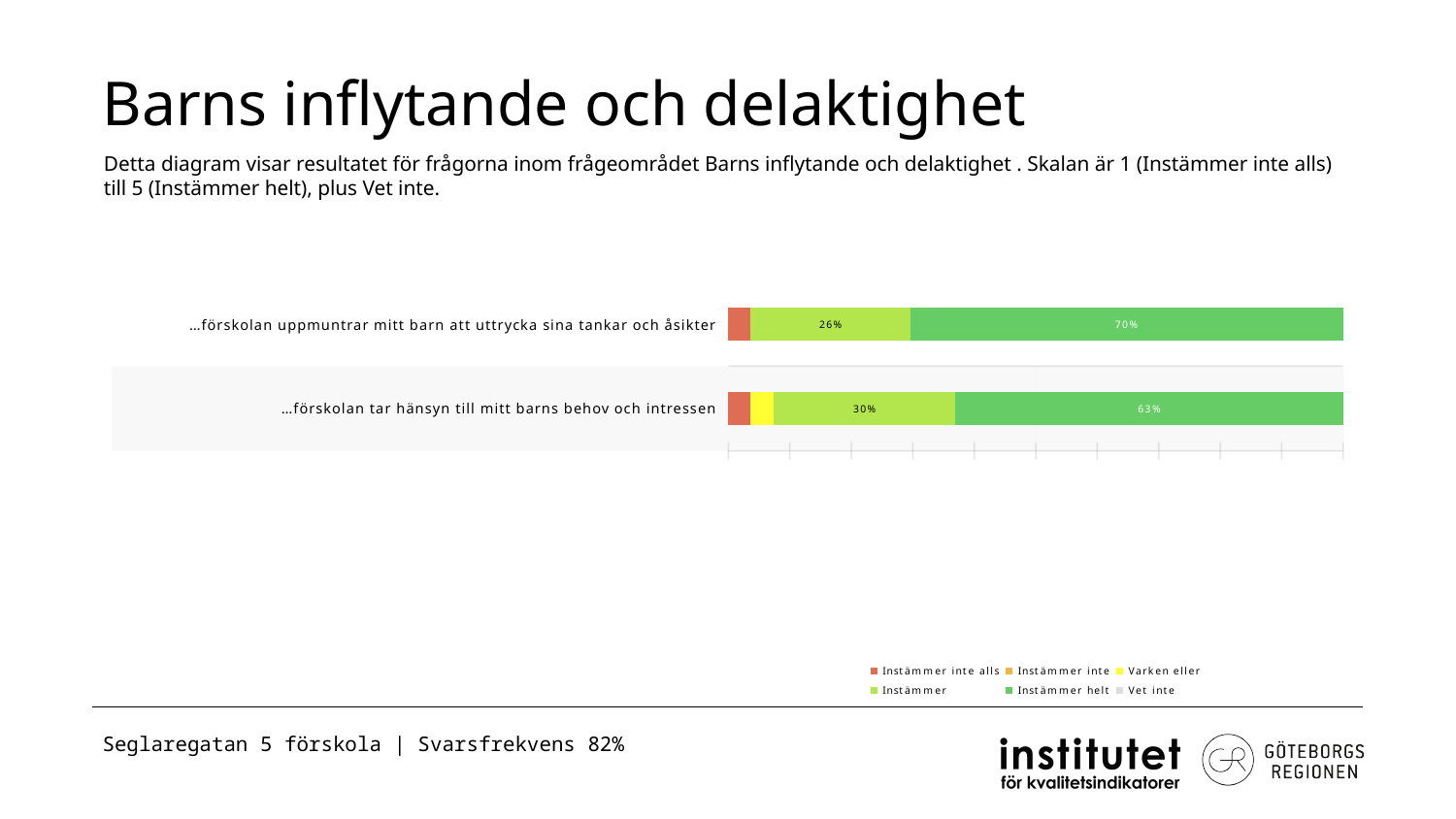
What is the value of the "Instämmer" segment for "…förskolan uppmuntrar mitt barn att uttrycka sina tankar och åsikter"? 26% Which statement has the lower "Instämmer" share? …förskolan uppmuntrar mitt barn att uttrycka sina tankar och åsikter What kind of chart is shown on the slide? Stacked bar chart How many statements (bars) are shown in the chart? 2 What is the value of the "Instämmer" segment for "…förskolan tar hänsyn till mitt barns behov och intressen"? 30% What is the value of the "Instämmer helt" segment for "…förskolan uppmuntrar mitt barn att uttrycka sina tankar och åsikter"? 70% What is the difference in percentage points between the "Instämmer helt" values of the two statements? 7 Is the "Instämmer helt" value larger for "…förskolan tar hänsyn till mitt barns behov och intressen" or for "…förskolan uppmuntrar mitt barn att uttrycka sina tankar och åsikter"? …förskolan uppmuntrar mitt barn att uttrycka sina tankar och åsikter What is the difference in percentage points between the "Instämmer" values of the two statements? 4 Which statement has the higher "Instämmer helt" share? …förskolan uppmuntrar mitt barn att uttrycka sina tankar och åsikter How many series does the legend list? 6 What is the value of the "Instämmer helt" segment for "…förskolan tar hänsyn till mitt barns behov och intressen"? 63%